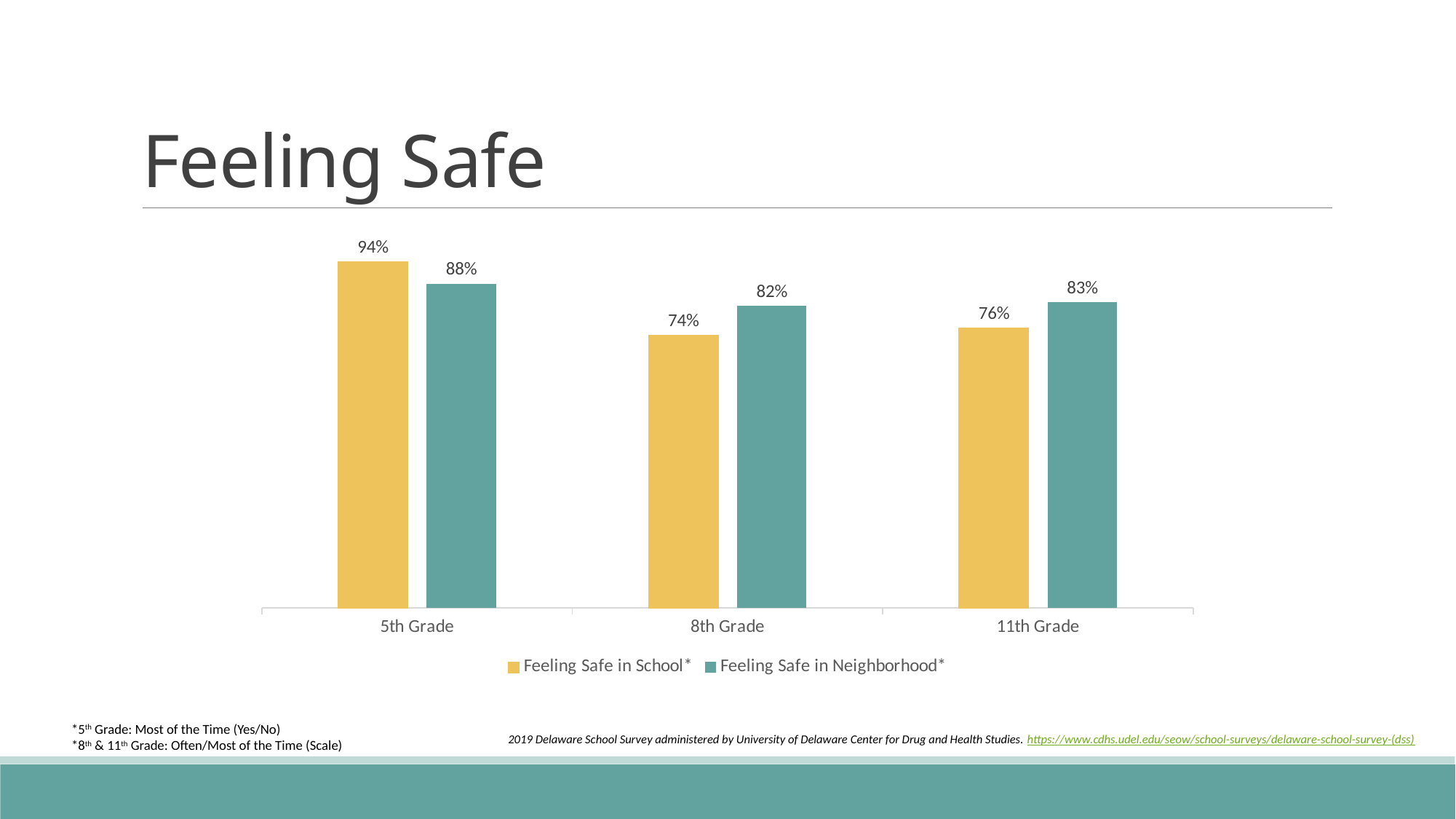
Which colour represents Feeling Safe in School in the chart? Yellow How many series does the legend list? 2 Which grade has the highest value for Feeling Safe in Neighborhood? 5th Grade What is the difference between Feeling Safe in School and Feeling Safe in Neighborhood for 5th Grade? 6% What is the value for Feeling Safe in School for 11th Grade? 76% What is the value for Feeling Safe in Neighborhood for 8th Grade? 82% What is the difference between Feeling Safe in Neighborhood for 5th Grade and 11th Grade? 5% Which grade has the lowest value for Feeling Safe in School? 8th Grade What kind of chart is shown on the slide? Bar chart For 8th Grade, which is larger: Feeling Safe in School or Feeling Safe in Neighborhood? Feeling Safe in Neighborhood How many grade categories are shown on the x axis? 3 What percentage of 5th Grade students report Feeling Safe in School? 94%